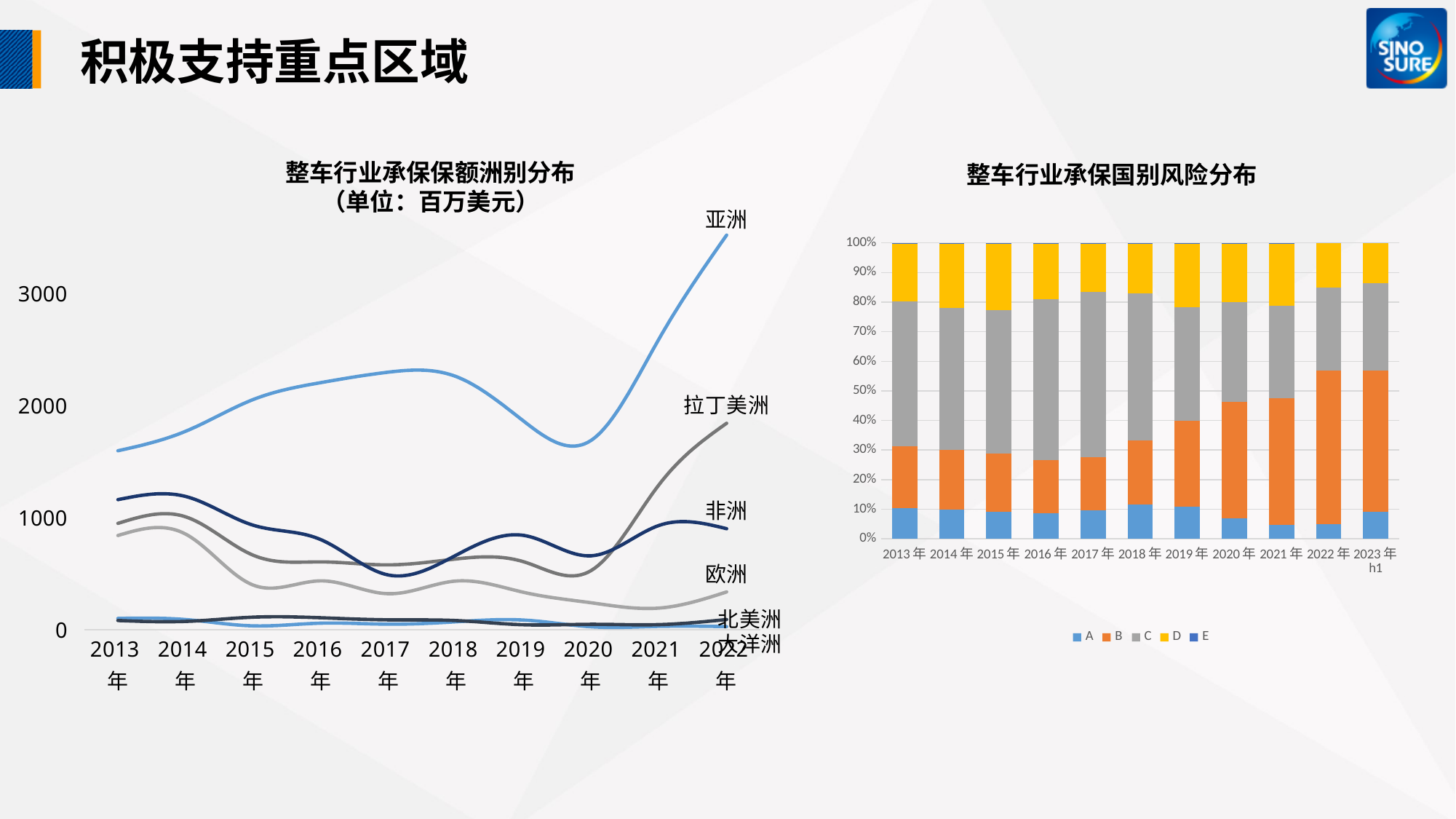
What kind of chart is the left chart titled 整车行业承保保额洲别分布? line chart In the right chart (整车行业承保国别风险分布), does the share of series B generally rise or fall from 2013 年 to 2023 年h1? rise In the left chart (整车行业承保保额洲别分布), is the value for 亚洲 in 2013 greater or less than 2000? less In the left chart (整车行业承保保额洲别分布), does the 亚洲 line rise or fall from 2020 to 2022? rise What kind of chart is the right chart titled 整车行业承保国别风险分布? stacked bar chart In the left chart (整车行业承保保额洲别分布), is the value for 亚洲 in 2022 greater or less than 3000? greater In the right chart (整车行业承保国别风险分布), how many bars (time periods) are shown? 11 In the left chart (整车行业承保保额洲别分布), is the value for 拉丁美洲 in 2022 greater or less than 1000? greater In the left chart (整车行业承保保额洲别分布), how many years are shown on the x axis? 10 In the left chart (整车行业承保保额洲别分布), how many regions (series) are plotted? 6 In the right chart (整车行业承保国别风险分布), how many series does the legend list? 5 In the left chart (整车行业承保保额洲别分布), which region has the highest value in 2022? 亚洲